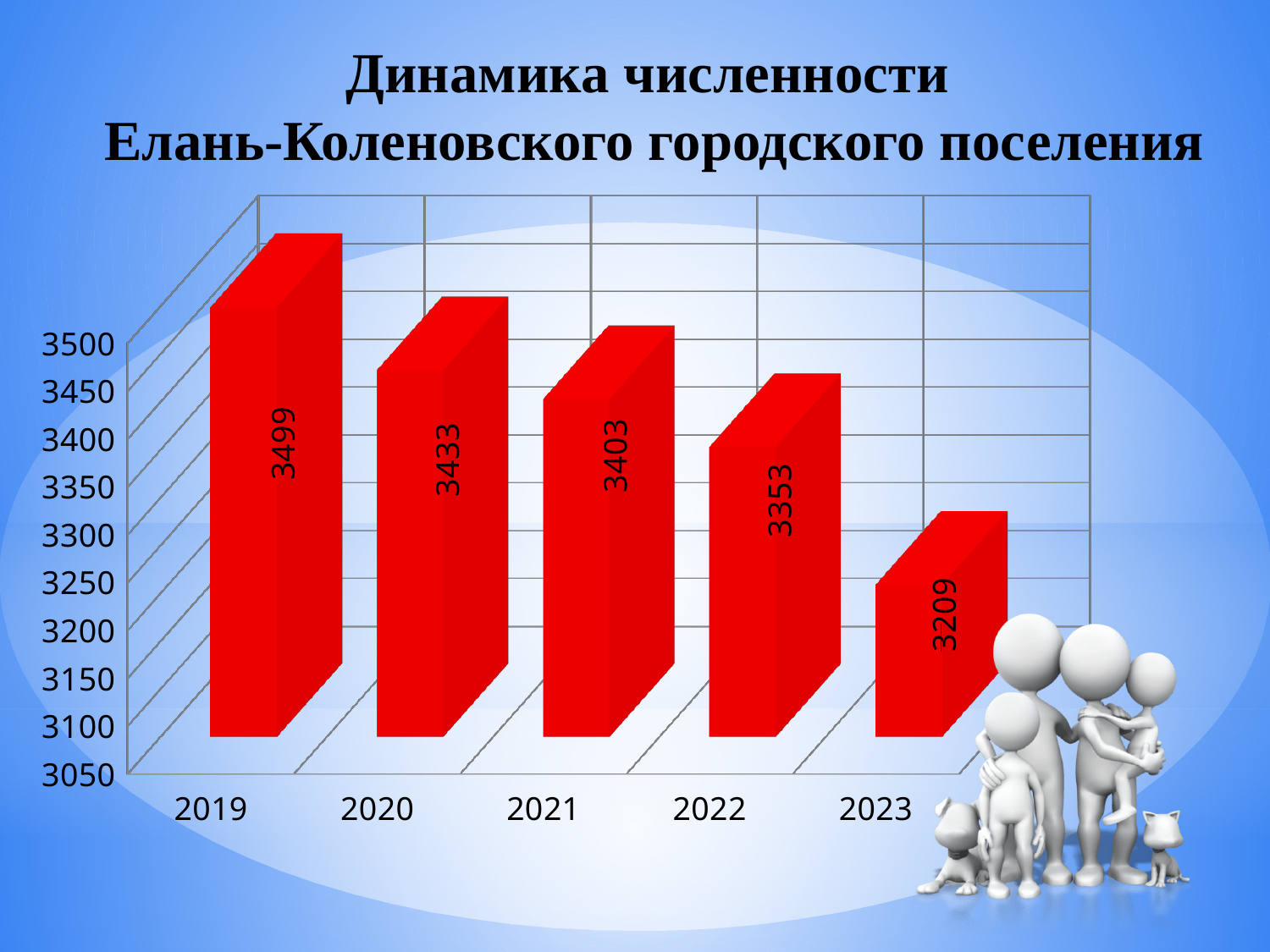
Which year has the lowest value? 2023 What is the value for 2023? 3209 What is the difference between the values for 2019 and 2023? 290 Which year has the highest value? 2019 How many years are shown on the x axis? 5 What is the difference between the values for 2021 and 2022? 50 What is the value for 2021? 3403 What kind of chart is shown on the slide? bar chart What is the value for 2019? 3499 Which is larger, the value for 2020 or the value for 2022? 2020 Is the value for 2022 greater or less than 3300? greater Do the values rise or fall from 2019 to 2023? fall